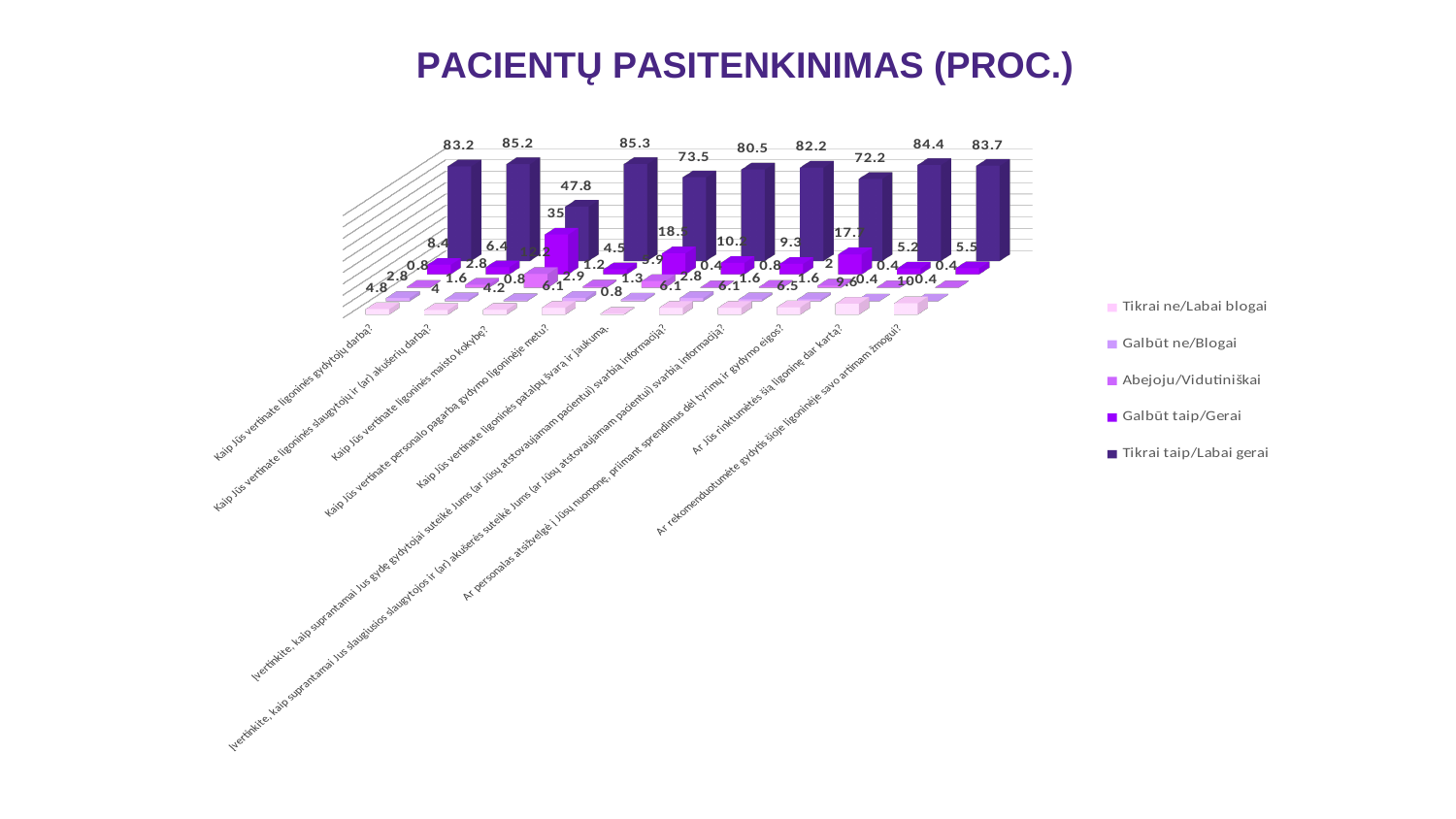
What is the difference between the 'Tikrai taip/Labai gerai' values for 'Kaip Jūs vertinate ligoninės slaugytojų ir (ar) akušerių darbą?' (85.2) and 'Kaip Jūs vertinate ligoninės maisto kokybę?' (47.8)? 37.4 What is the 'Tikrai taip/Labai gerai' value for 'Ar Jūs rinktumėtės šią ligoninę dar kartą?' 84.4 What is the 'Tikrai taip/Labai gerai' value for 'Kaip Jūs vertinate ligoninės maisto kokybę?' 47.8 How many series does the legend list? 5 How many categories (questions) are plotted on the chart? 10 What is the 'Tikrai taip/Labai gerai' value for 'Ar rekomenduotumėte gydytis šioje ligoninėje savo artimam žmogui?' 83.7 Which category has the lowest 'Tikrai taip/Labai gerai' value? Kaip Jūs vertinate ligoninės maisto kokybę? What is the title of the chart? PACIENTŲ PASITENKINIMAS (PROC.) What is the 'Tikrai taip/Labai gerai' value for 'Kaip Jūs vertinate ligoninės gydytojų darbą?' 83.2 Which legend entry is shown with the darkest purple colour? Tikrai taip/Labai gerai Which is larger: the 'Tikrai taip/Labai gerai' value for 'Kaip Jūs vertinate ligoninės gydytojų darbą?' or for 'Kaip Jūs vertinate ligoninės patalpų švarą ir jaukumą'? Kaip Jūs vertinate ligoninės gydytojų darbą? What kind of chart is shown on the slide? Bar chart